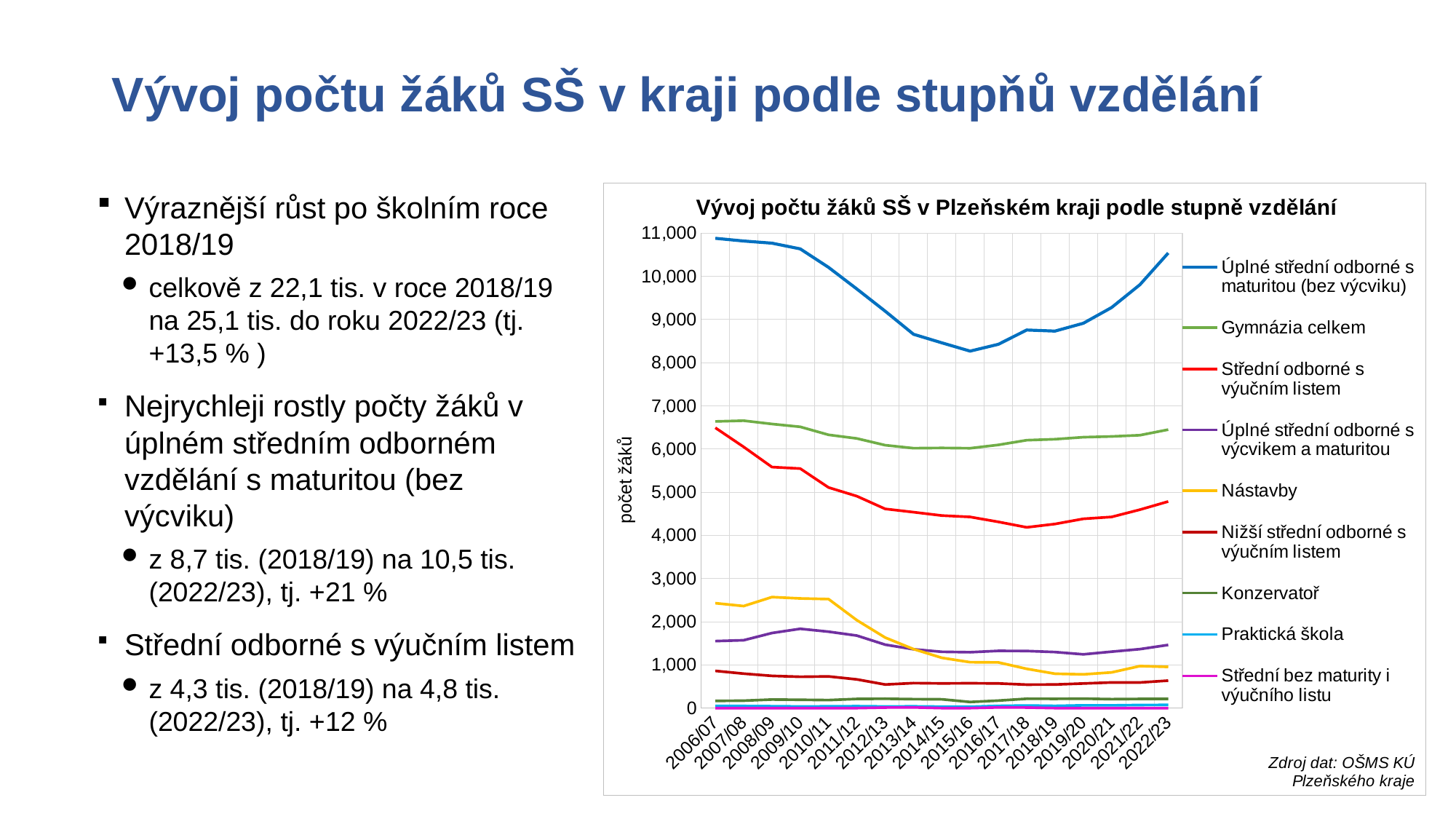
In 2022/23, which is larger: Gymnázia celkem or Střední odborné s výučním listem? Gymnázia celkem Is the value for Úplné střední odborné s maturitou (bez výcviku) in 2006/07 greater or less than 10,000? greater Does the value for Úplné střední odborné s maturitou (bez výcviku) rise or fall from 2006/07 to 2015/16? fall What is the label of the vertical axis of the chart? počet žáků Is the value for Gymnázia celkem in 2022/23 greater or less than 7,000? less What kind of chart is shown on the slide? line chart Is the value for Nástavby in 2006/07 greater or less than 2,000? greater Which series has the highest value in 2006/07? Úplné střední odborné s maturitou (bez výcviku) How many school years are shown on the x axis of the chart? 17 What is the title of the chart? Vývoj počtu žáků SŠ v Plzeňském kraji podle stupně vzdělání How many series does the chart legend list? 9